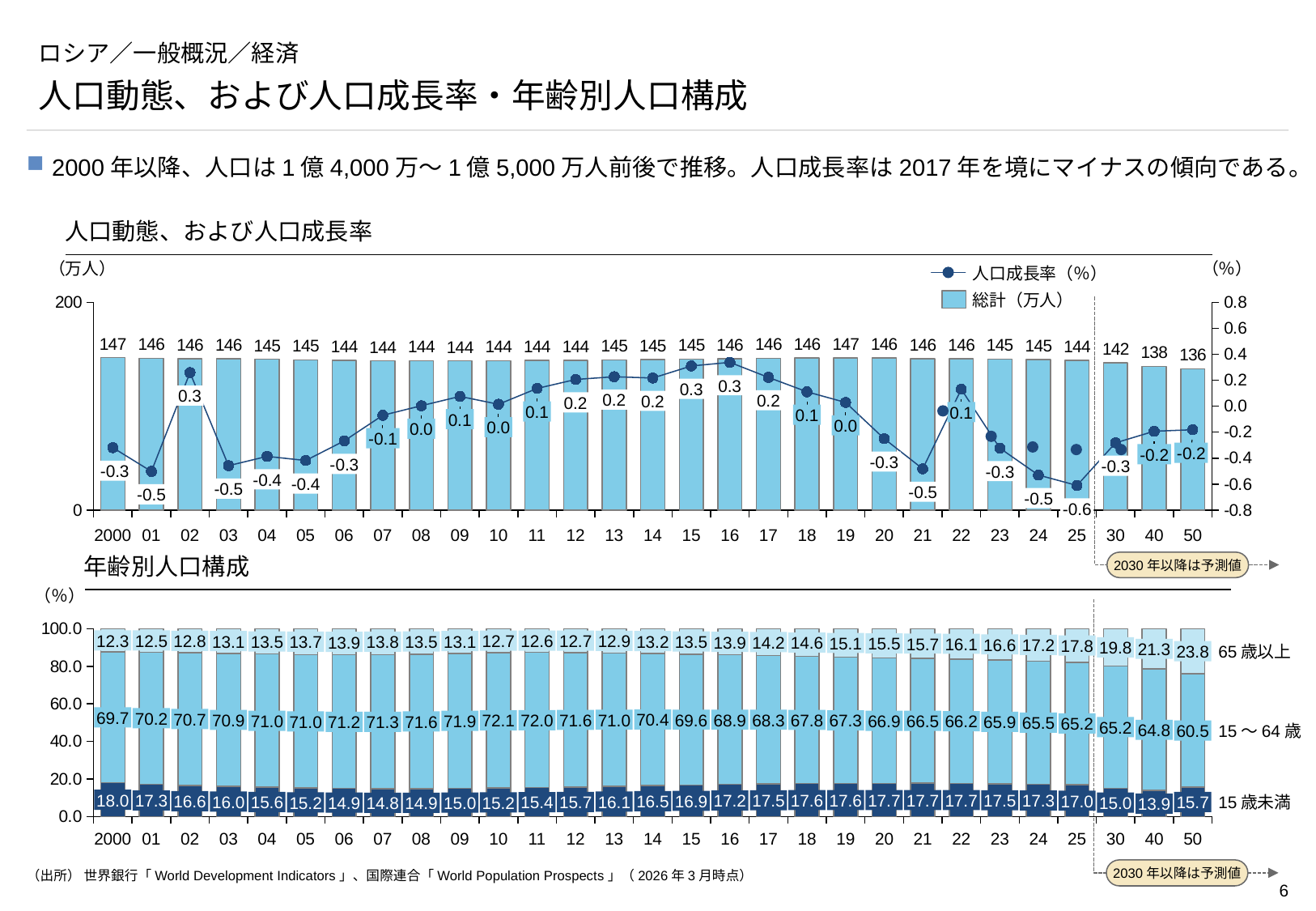
In the bottom chart (年齢別人口構成), what is the total of the stacked bar for 2000? 100.0 In the top chart (人口動態、および人口成長率), how many years are shown on the x axis? 29 In the top chart (人口動態、および人口成長率), which year has the lowest 総計 value? 2050 In the top chart (人口動態、および人口成長率), what is the difference between the 総計 values for 2000 and 2050? 11 In the bottom chart (年齢別人口構成), does the 65歳以上 share rise or fall from 2000 to 2050? Rise In the top chart (人口動態、および人口成長率), what is the 総計 value for 2050? 136 What kind of chart is the bottom chart (年齢別人口構成)? Stacked bar chart In the top chart (人口動態、および人口成長率), what is the 人口成長率 value for 2025? -0.6 In the top chart (人口動態、および人口成長率), which year has the higher 人口成長率, 2016 or 2021? 2016 In the bottom chart (年齢別人口構成), what is the 65歳以上 value for 2050? 23.8 In the top chart (人口動態、および人口成長率), which year has the lowest 人口成長率 value? 2025 In the top chart (人口動態、および人口成長率), how many series does the legend list? 2